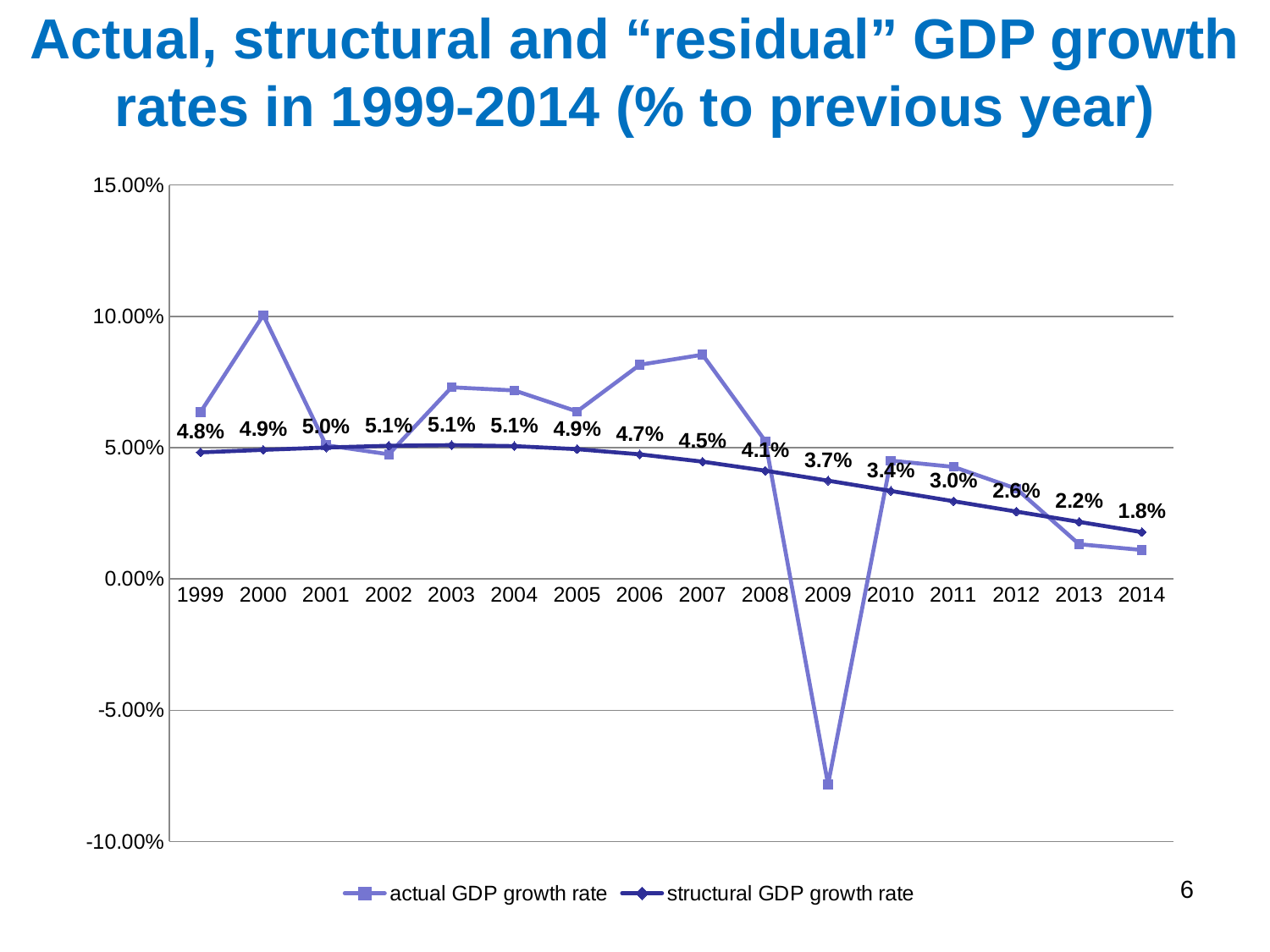
In which year is the actual GDP growth rate highest? 2000 In which year is the structural GDP growth rate lowest? 2014 What is the difference between the structural GDP growth rate in 1999 and in 2014? 3.0 percentage points What kind of chart is shown on the slide? line chart In which year is the actual GDP growth rate lowest? 2009 Is the actual GDP growth rate for 2009 greater or less than -5.00%? less What is the structural GDP growth rate for 2014? 1.8% What is the structural GDP growth rate for 2009? 3.7% How many series does the legend list? 2 How many years are shown on the x axis? 16 Which year has the higher structural GDP growth rate, 2008 or 2011? 2008 What is the structural GDP growth rate for 2003? 5.1%